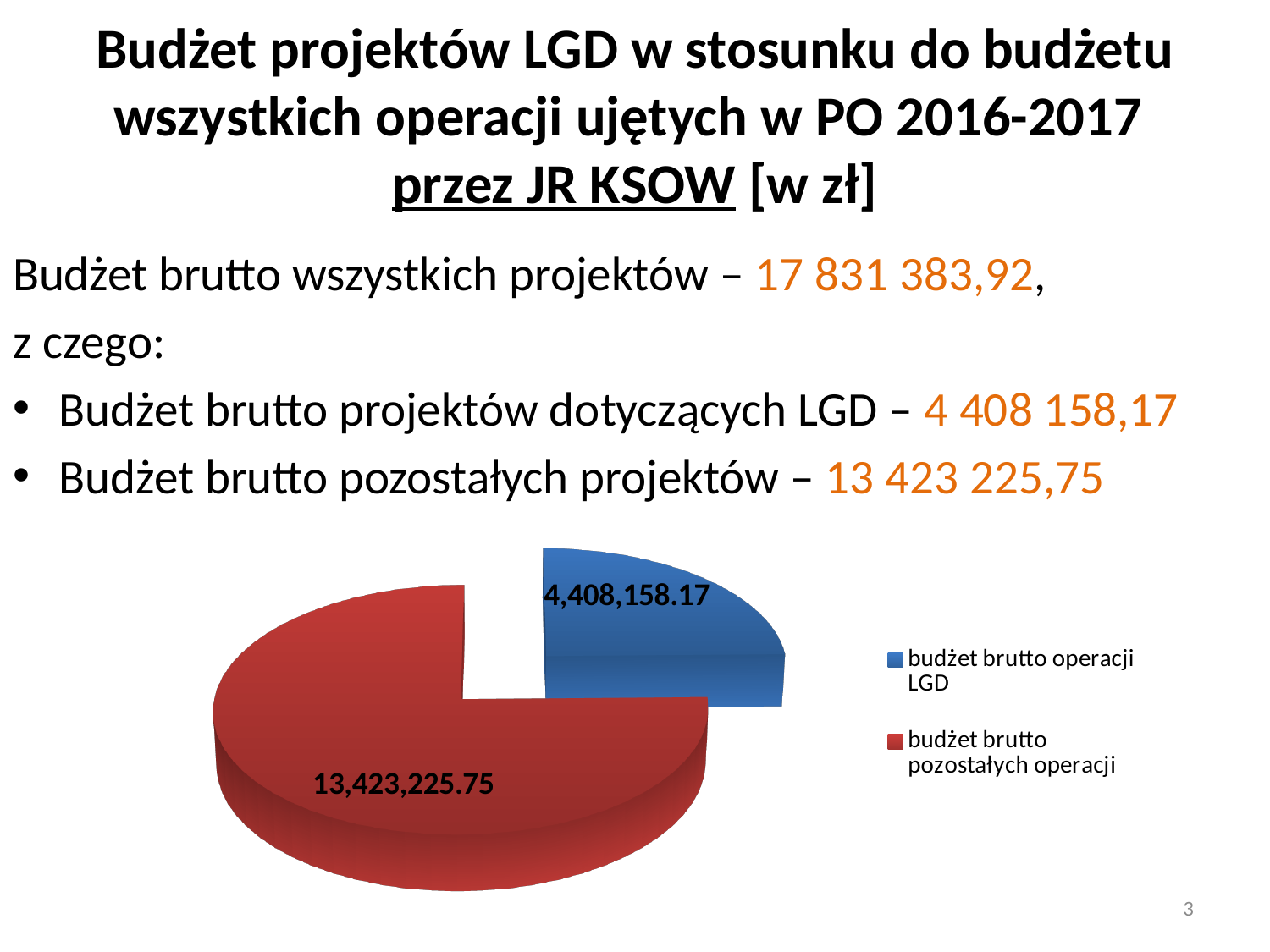
How many entries does the legend of the pie chart list? 2 What is the difference between the 'budżet brutto pozostałych operacji' slice and the 'budżet brutto operacji LGD' slice? 9,015,067.58 Which is larger in the pie chart: 'budżet brutto operacji LGD' or 'budżet brutto pozostałych operacji'? budżet brutto pozostałych operacji What colour is the 'budżet brutto pozostałych operacji' slice in the pie chart? red How many slices does the pie chart have? 2 What is the value of the 'budżet brutto operacji LGD' slice in the pie chart? 4,408,158.17 What kind of chart is shown on the slide? pie chart What is the total of the two slices in the pie chart? 17,831,383.92 Which slice of the pie chart is the largest? budżet brutto pozostałych operacji What is the value of the 'budżet brutto pozostałych operacji' slice in the pie chart? 13,423,225.75 Which slice of the pie chart is the smallest? budżet brutto operacji LGD